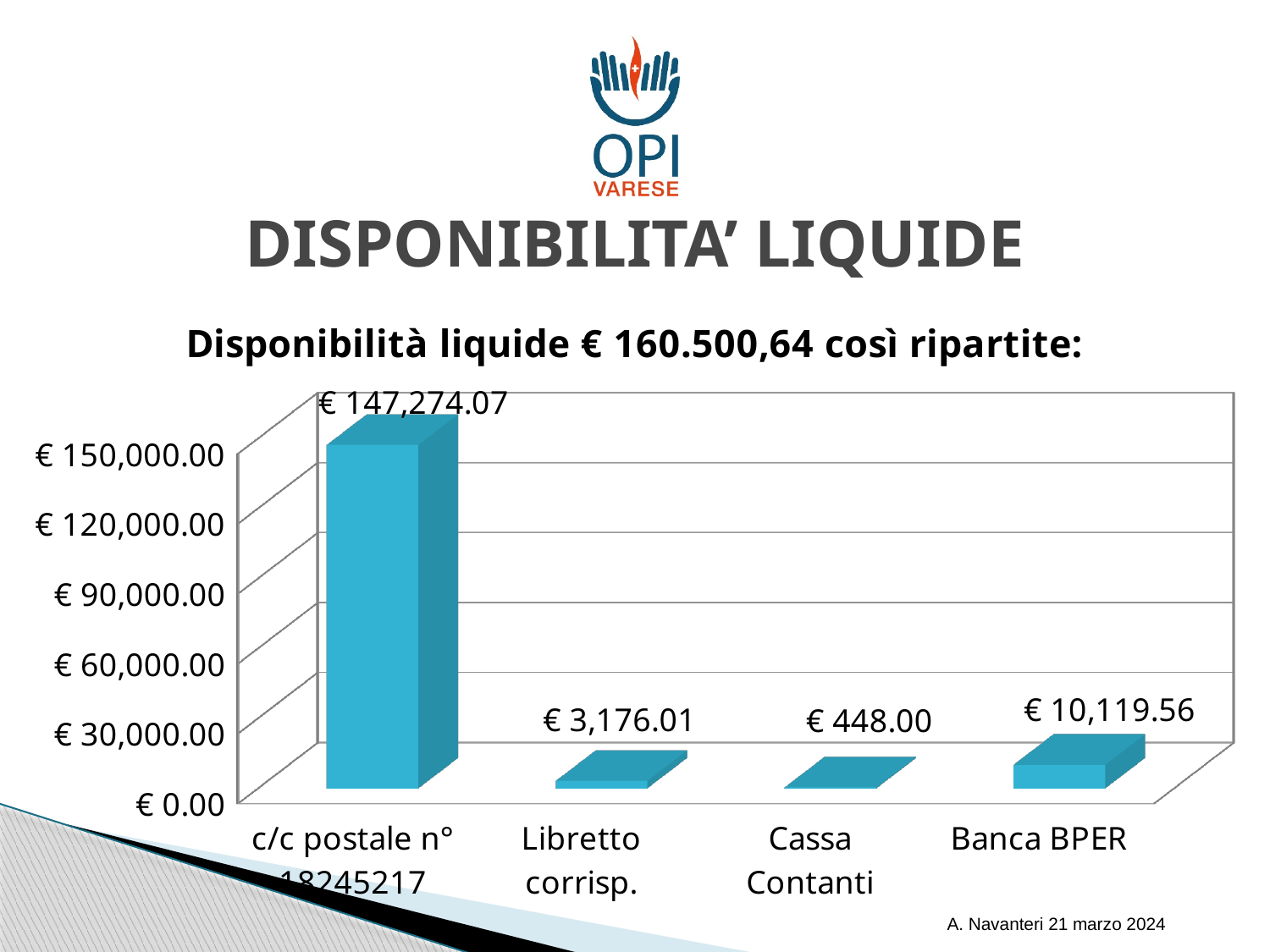
What is the value for Libretto corrisp.? € 3,176.01 Which category has the highest value? c/c postale n° 18245217 Is the value for c/c postale n° 18245217 greater or less than € 120,000.00? greater What is the value for Banca BPER? € 10,119.56 What is the value for Cassa Contanti? € 448.00 What is the difference between the values for Banca BPER and Libretto corrisp.? € 6,943.55 Which category has the lowest value? Cassa Contanti How many categories are shown in the chart? 4 What is the value for c/c postale n° 18245217? € 147,274.07 Which is larger, the value for Libretto corrisp. or the value for Banca BPER? Banca BPER What is the difference between the values for c/c postale n° 18245217 and Banca BPER? € 137,154.51 What kind of chart is shown on the slide? bar chart